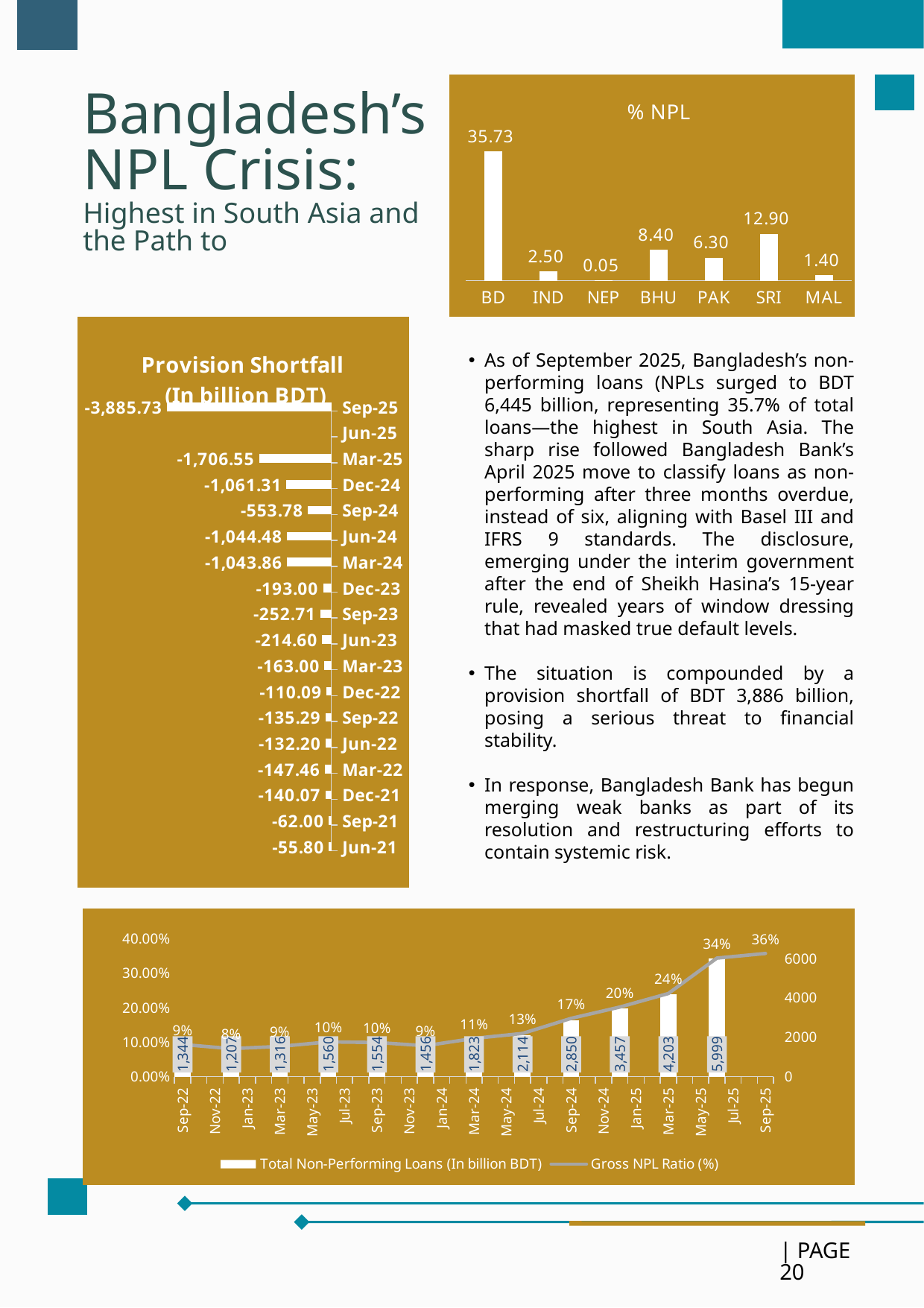
In the % NPL chart, how many countries are shown? 7 In the Provision Shortfall chart, what is the value for Sep-25? -3,885.73 In the % NPL chart, what is the difference between the values for SRI and BHU? 4.50 In the Provision Shortfall chart, what is the value for Jun-21? -55.80 In the bottom chart, what is the highest labelled value for Total Non-Performing Loans (In billion BDT)? 5,999 In the % NPL chart, which is larger, the value for PAK or the value for IND? PAK In the Provision Shortfall chart, what is the value for Mar-25? -1,706.55 In the bottom chart, how many series does the legend list? 2 In the % NPL chart, what is the value for BD? 35.73 In the Provision Shortfall chart, what kind of chart is used? Bar chart In the % NPL chart, which country has the lowest value? NEP In the bottom chart, does the Gross NPL Ratio (%) generally rise or fall from Sep-22 to Sep-25? Rise